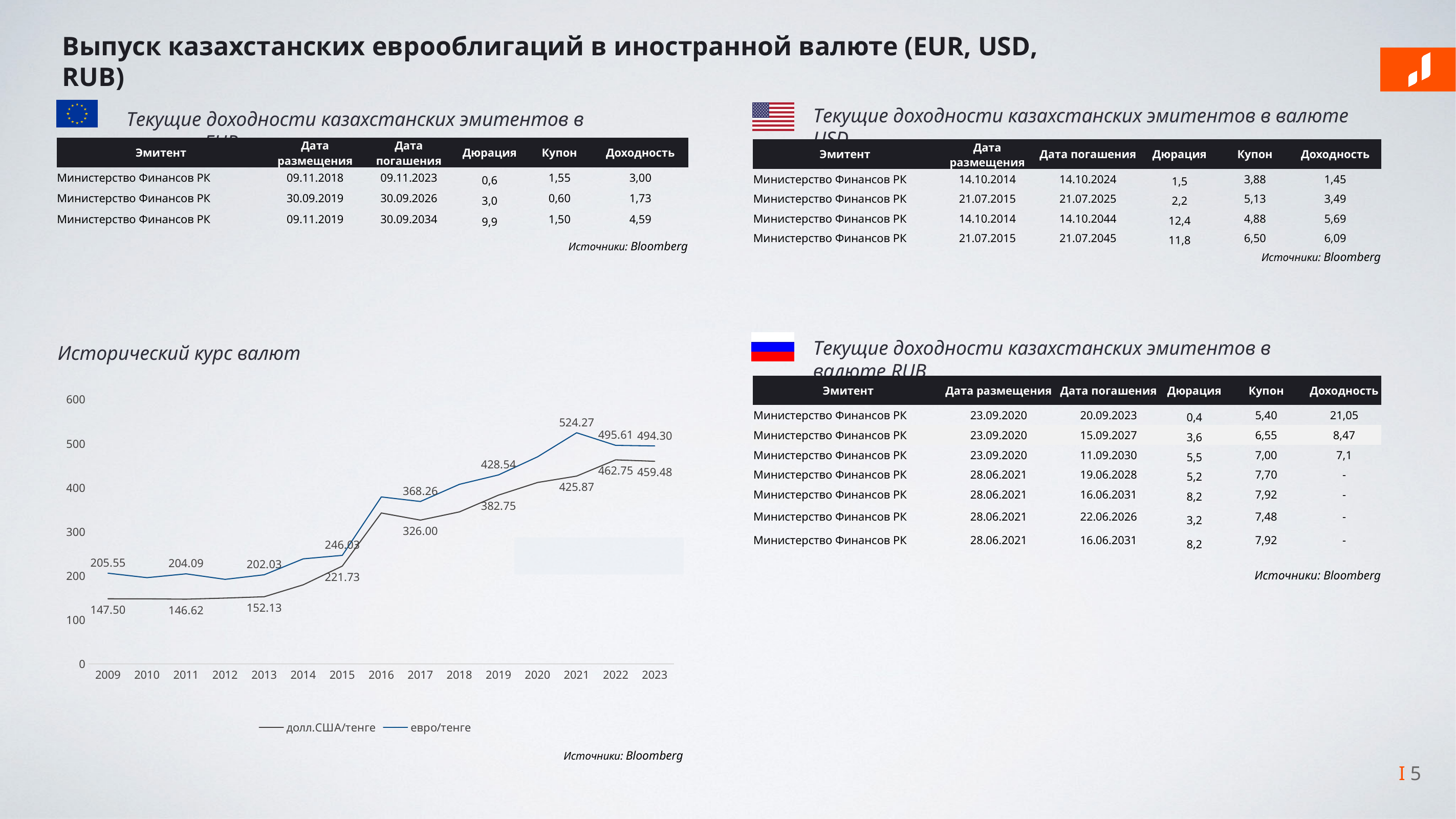
In the 'Исторический курс валют' chart, is the value of долл.США/тенге in 2016 greater or less than 300? greater How many years are shown on the x axis of the 'Исторический курс валют' chart? 15 In the 'Исторический курс валют' chart, in which year does евро/тенге reach its highest value? 2021 In the 'Исторический курс валют' chart, what is the difference between евро/тенге and долл.США/тенге in 2023? 34.82 What are the two legend entries of the 'Исторический курс валют' chart? долл.США/тенге and евро/тенге In the 'Исторический курс валют' chart, what is the value of долл.США/тенге in 2023? 459.48 How many series does the legend of the 'Исторический курс валют' chart list? 2 In the 'Исторический курс валют' chart, which series is higher in 2019: долл.США/тенге or евро/тенге? евро/тенге In the 'Исторический курс валют' chart, what is the value of евро/тенге in 2021? 524.27 In the 'Исторический курс валют' chart, do the values of долл.США/тенге generally rise or fall from 2009 to 2023? rise In the 'Исторический курс валют' chart, what is the value of долл.США/тенге in 2009? 147.50 What kind of chart is the 'Исторический курс валют' chart? line chart